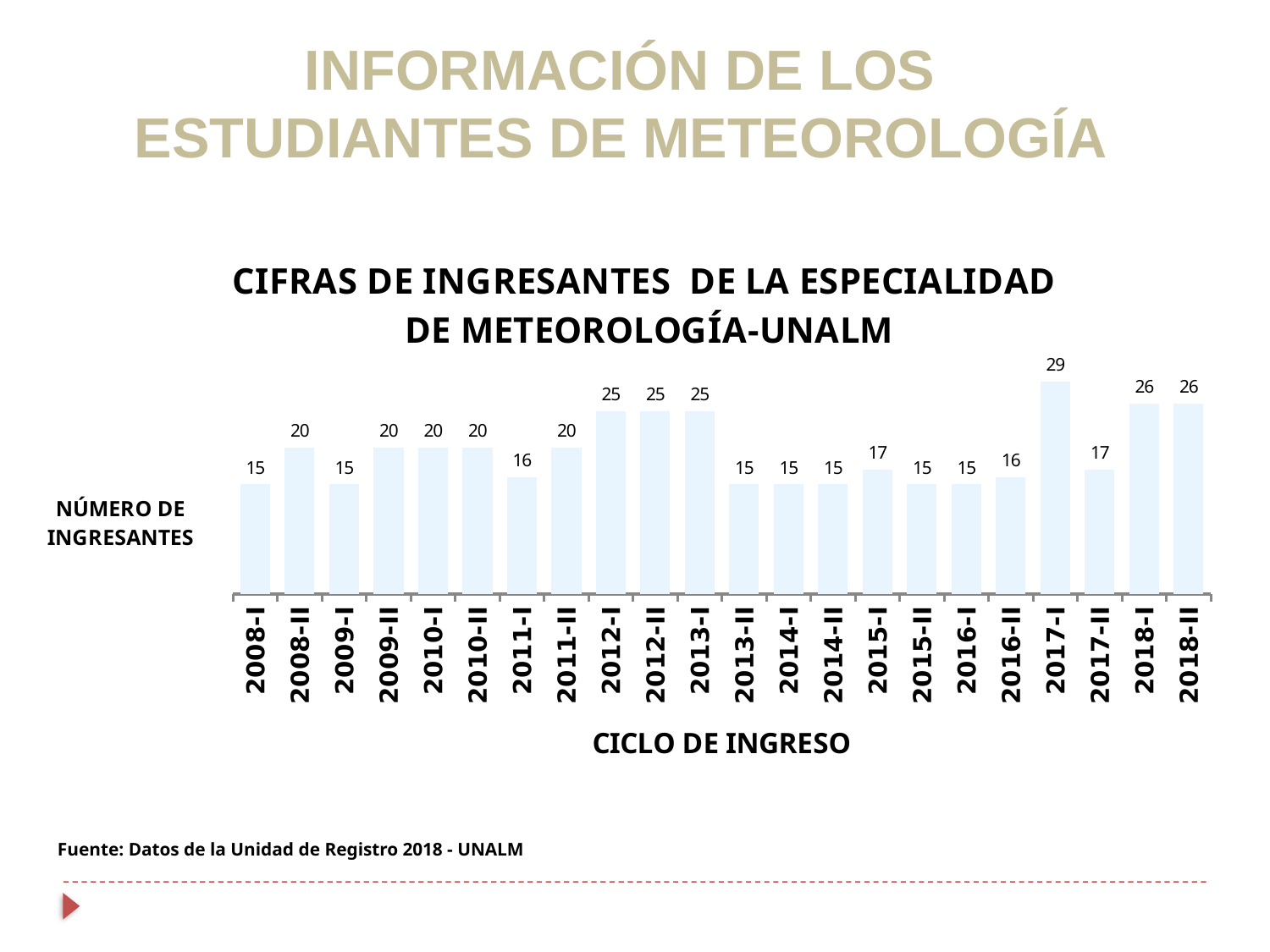
What is the value shown for 2015-I? 17 How many ciclos de ingreso are shown on the x axis? 22 What is the difference between the values for 2012-I and 2013-II? 10 What is the label of the x axis of the chart? CICLO DE INGRESO What is the difference between the values for 2017-I and 2017-II? 12 Which ciclo de ingreso has the highest number of ingresantes? 2017-I What kind of chart is shown on the slide? Bar chart Which is larger, the value for 2008-II or the value for 2016-II? 2008-II What is the lowest value shown on the chart? 15 What is the value shown for 2018-II? 26 What is the value shown for 2011-I? 16 What is the number of ingresantes for 2017-I? 29